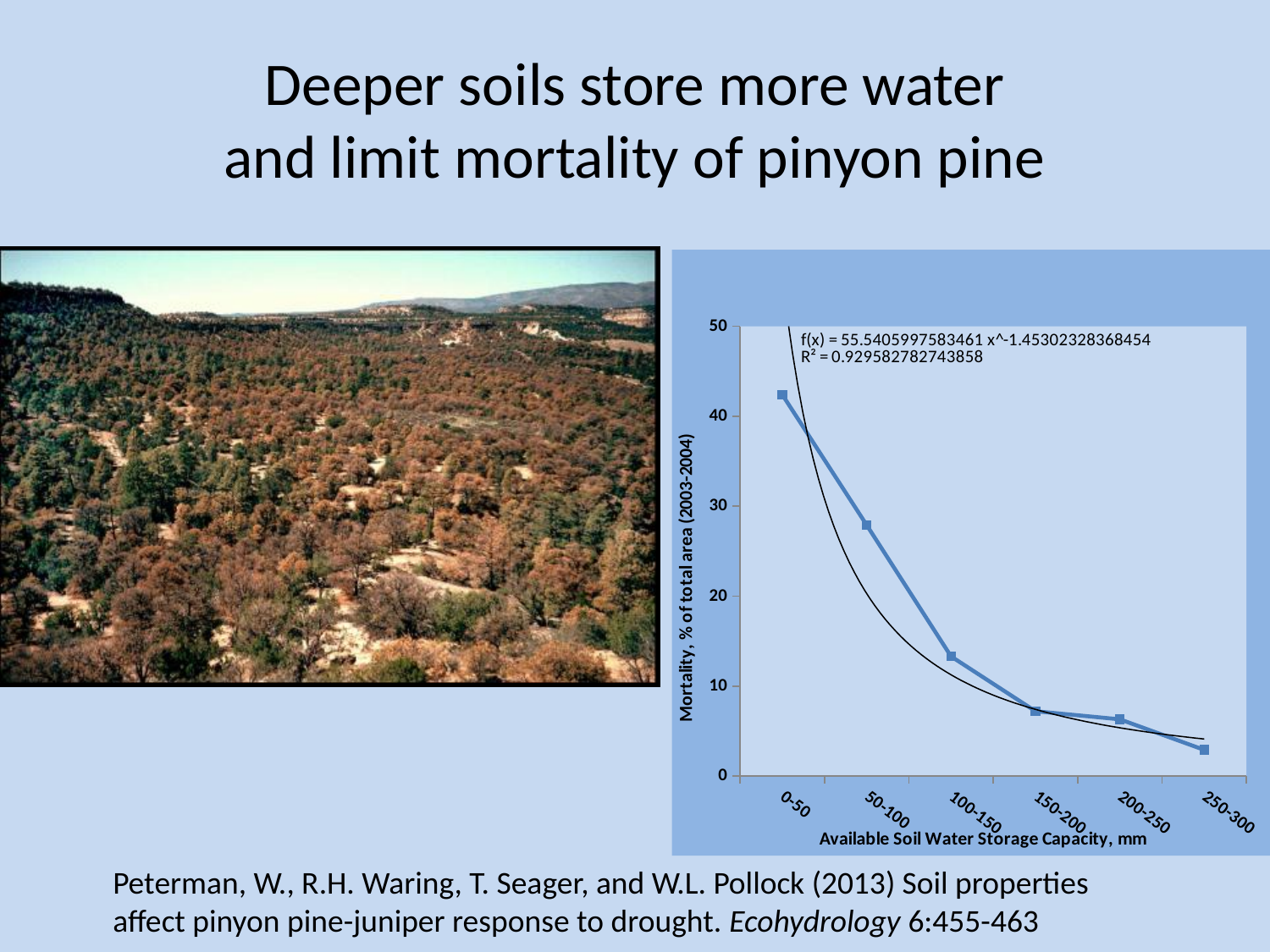
Is the mortality value for the 0-50 mm category greater or less than 40? greater Which has higher mortality, the 50-100 mm category or the 150-200 mm category? 50-100 What kind of chart is shown on the slide? line chart Is the mortality value for the 100-150 mm category greater or less than 20? less Does mortality rise or fall as available soil water storage capacity increases along the x axis? fall What is the title of the y axis of the chart? Mortality, % of total area (2003-2004) Is the mortality value for the 250-300 mm category greater or less than 10? less How many soil water storage capacity categories are plotted along the x axis? 6 Which soil water storage capacity category has the lowest mortality? 250-300 What R² value is printed for the fitted trend line on the chart? 0.929582782743858 Which soil water storage capacity category has the highest mortality? 0-50